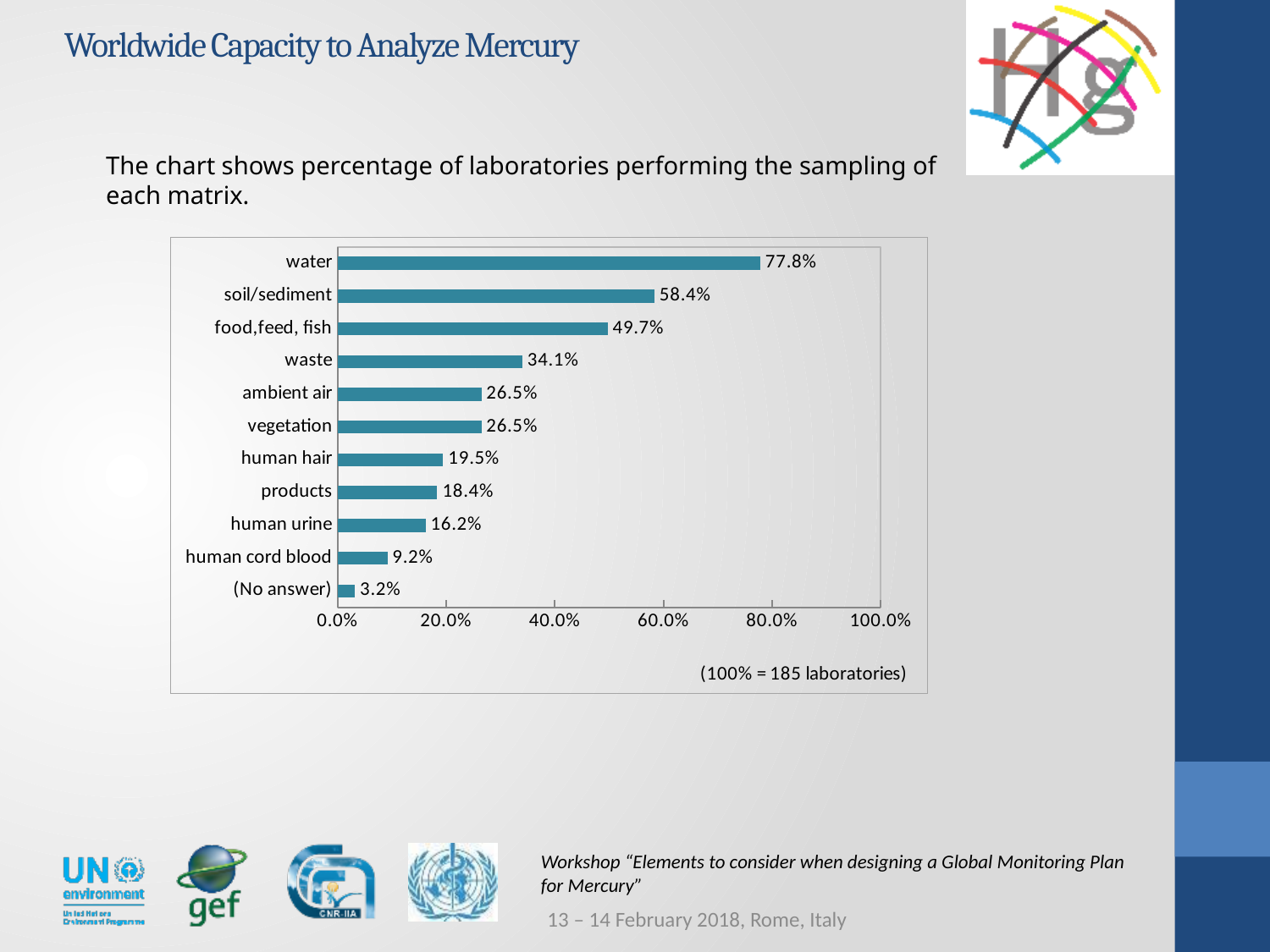
Which matrix has the highest percentage of laboratories? water How many categories are shown in the chart? 11 Is the value for soil/sediment greater or less than 60.0%? less What kind of chart is shown on the slide? bar chart What is the value shown for human cord blood? 9.2% What percentage is shown for waste? 34.1% According to the note on the chart, how many laboratories correspond to 100%? 185 laboratories Which is larger, the value for food,feed, fish or the value for waste? food,feed, fish What percentage of laboratories perform sampling of water? 77.8% What is the difference between the values for water and soil/sediment? 19.4% Which category has the lowest value in the chart? (No answer) What is the difference between the values for human hair and human urine? 3.3%